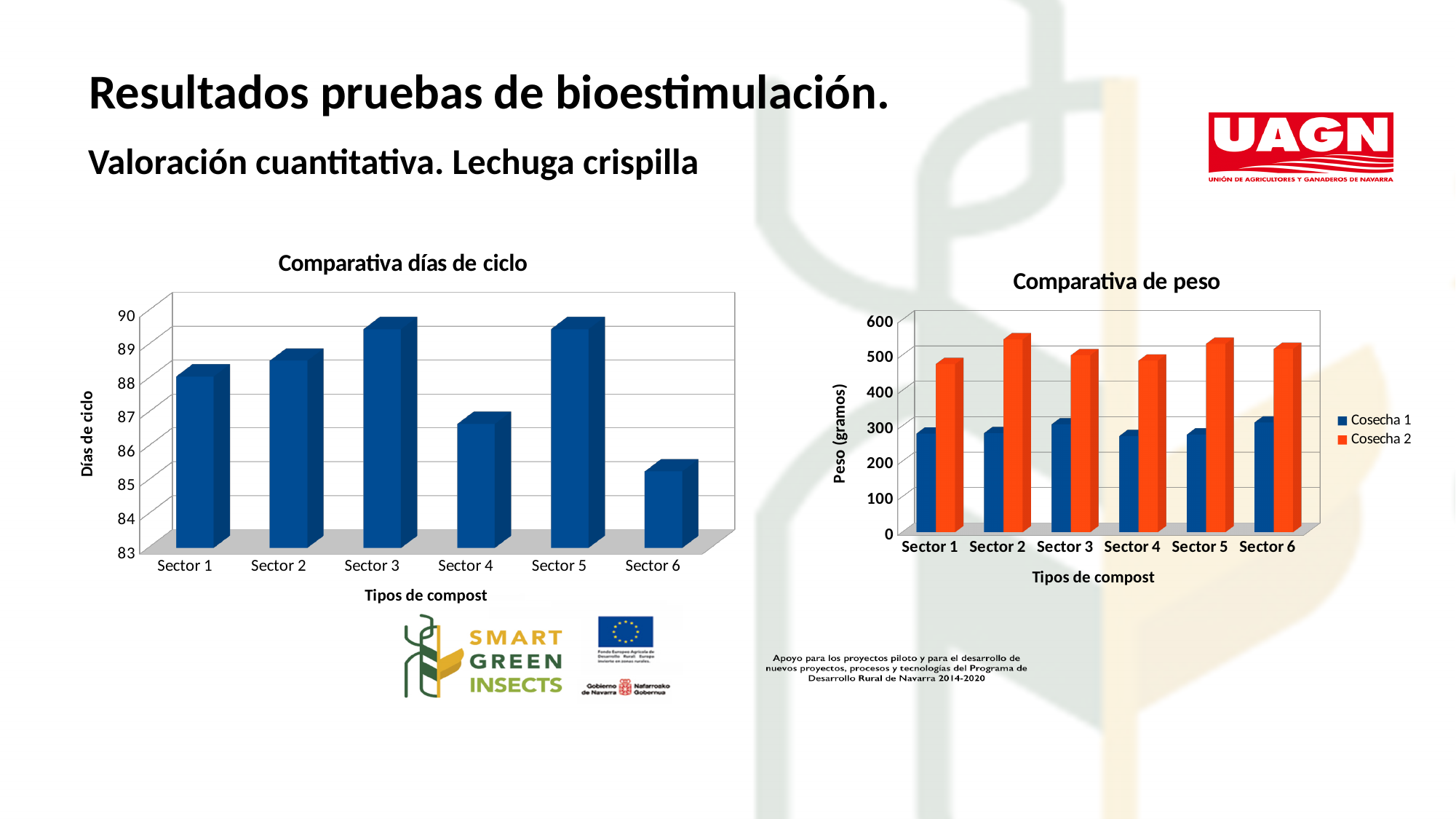
What is the y-axis title of the 'Comparativa días de ciclo' chart? Días de ciclo How many sectors are shown in the 'Comparativa días de ciclo' chart? 6 How many series does the legend of the 'Comparativa de peso' chart list? 2 In the 'Comparativa días de ciclo' chart, which is larger, the value for Sector 1 or the value for Sector 6? Sector 1 In the 'Comparativa de peso' chart, is the Cosecha 1 value for Sector 3 greater or less than 400? less What is the x-axis title of the 'Comparativa de peso' chart? Tipos de compost In the 'Comparativa de peso' chart, is the Cosecha 2 value for Sector 2 greater or less than 500? greater In the 'Comparativa de peso' chart, which series has the larger value for Sector 3, Cosecha 1 or Cosecha 2? Cosecha 2 What kind of chart is 'Comparativa días de ciclo'? Bar chart In the 'Comparativa días de ciclo' chart, is the value for Sector 6 greater or less than 86? less In the 'Comparativa días de ciclo' chart, which sector has the lowest value? Sector 6